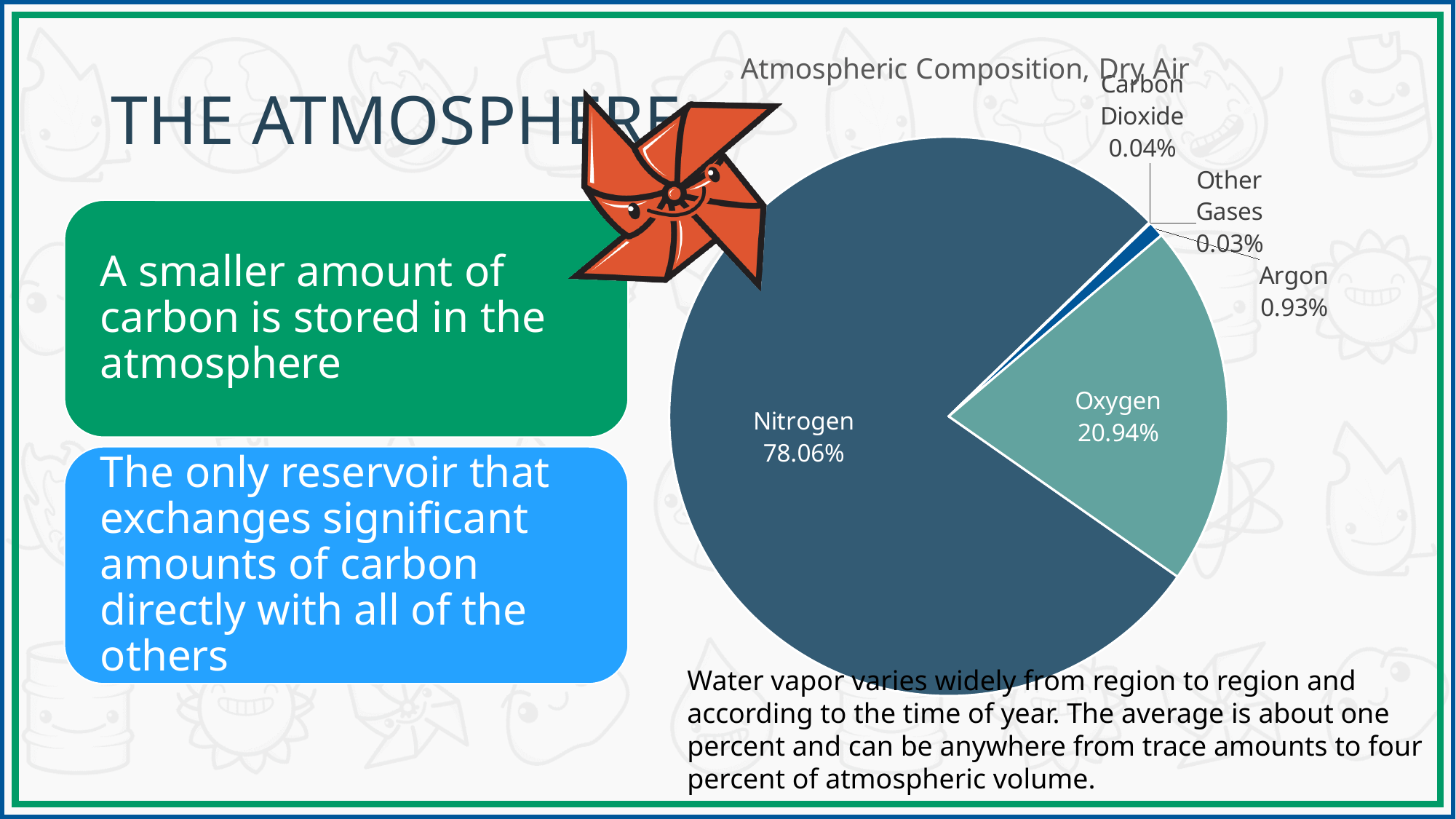
What kind of chart is shown on the slide? pie chart How many slices does the pie chart have? 5 What percentage of dry air is Oxygen according to the chart? 20.94% What value is shown for Carbon Dioxide in the chart? 0.04% What value is shown for Other Gases in the chart? 0.03% What value is shown for Argon in the chart? 0.93% What is the difference between the Nitrogen and Oxygen percentages in the chart? 57.12% Which category has the smallest value in the chart? Other Gases Which gas has the largest slice in the chart? Nitrogen What is the title of the chart? Atmospheric Composition, Dry Air What percentage of dry air is Nitrogen according to the chart? 78.06% Which is larger in the chart, Oxygen or Argon? Oxygen